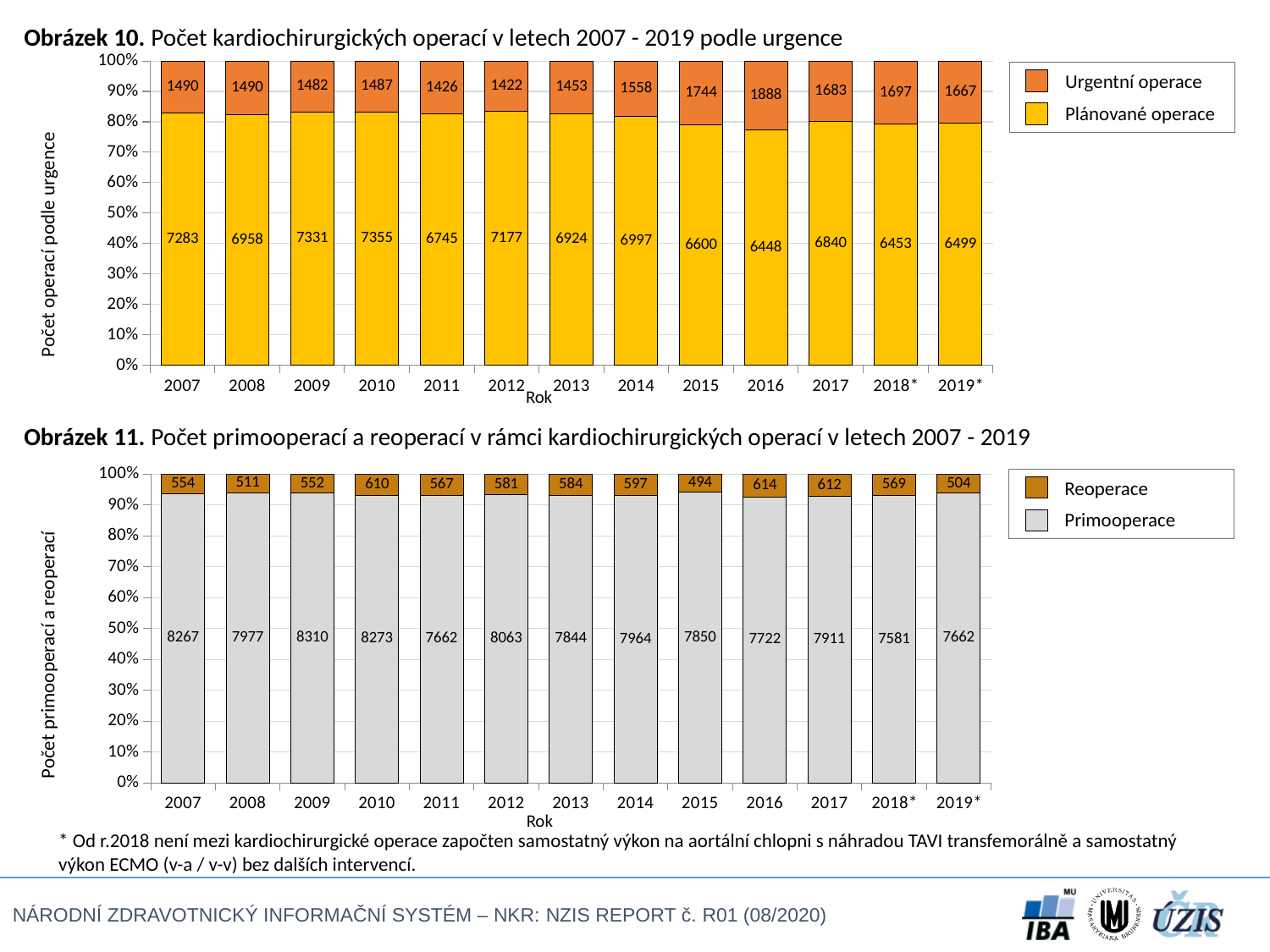
How many years are shown on the x axis of the chart 'Obrázek 11'? 13 In the chart 'Obrázek 10', which year has the lowest value for Plánované operace? 2016 In the chart 'Obrázek 11', which year has the lowest value for Reoperace? 2015 In the chart 'Obrázek 10', what is the value for Urgentní operace in 2016? 1888 In the chart 'Obrázek 10', what is the total of the stacked bar for 2007? 8773 What kind of chart is 'Obrázek 10'? stacked bar chart In the chart 'Obrázek 11', what is the value for Reoperace in 2010? 610 In the chart 'Obrázek 11', which year has the highest value for Primooperace? 2009 In the chart 'Obrázek 11', which is larger, the Primooperace value for 2007 or for 2018*? 2007 In the chart 'Obrázek 10', what is the value for Plánované operace in 2010? 7355 In the chart 'Obrázek 10', is the share of Plánované operace in 2016 greater or less than 80%? less In the chart 'Obrázek 10', what is the difference between the Urgentní operace values for 2016 and 2007? 398